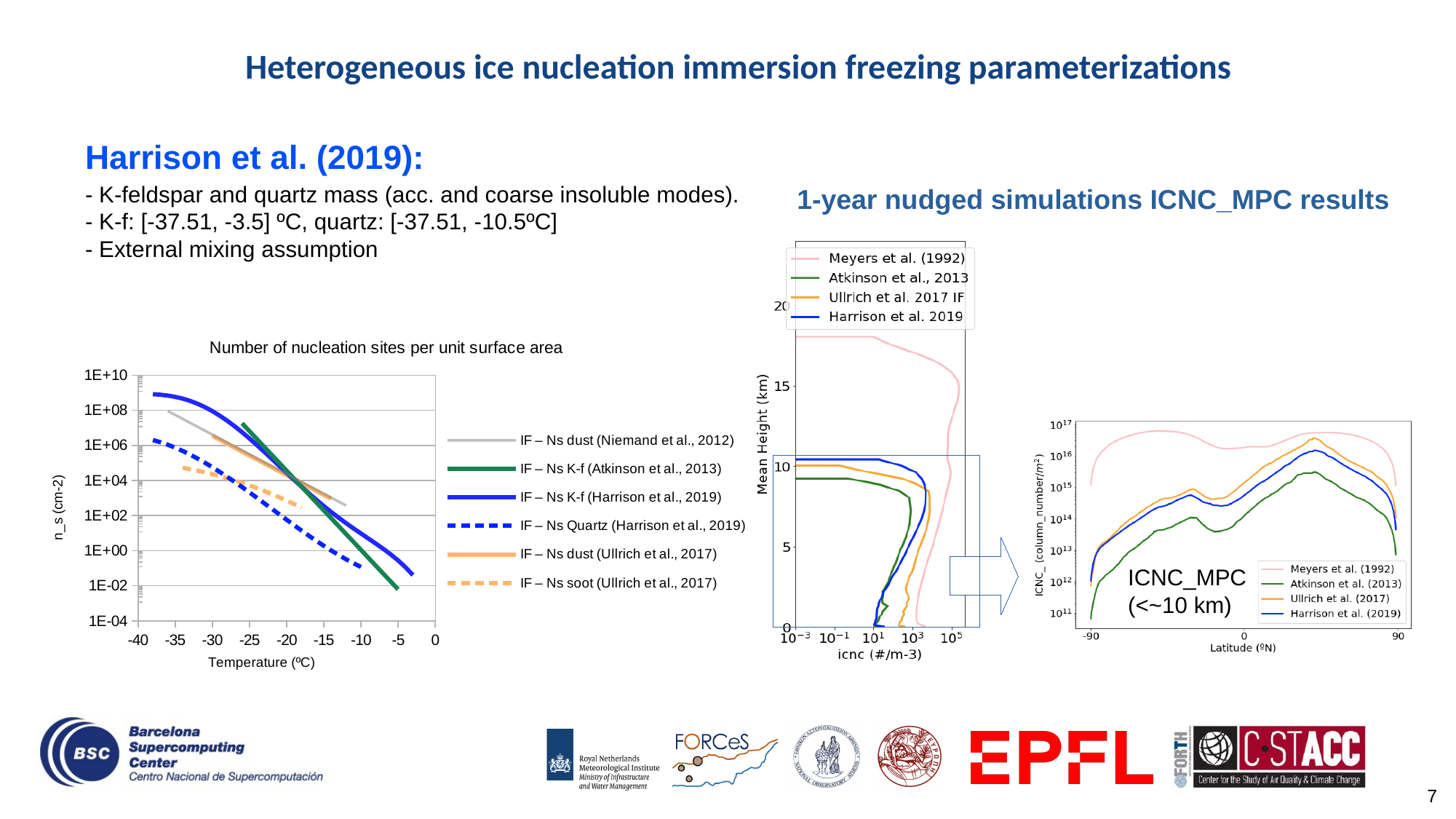
How many series does the legend of the 'Number of nucleation sites per unit surface area' chart list? 6 In the right-hand chart (ICNC column number versus Latitude), which series has the highest values across latitudes? Meyers et al. (1992) In the right-hand chart (ICNC column number versus Latitude), which series has the lowest values across latitudes? Atkinson et al. (2013) In the middle chart (icnc versus Mean Height), which series extends to the greatest mean height? Meyers et al. (1992) In the 'Number of nucleation sites per unit surface area' chart, is the value of IF – Ns K-f (Harrison et al., 2019) at -35 ºC greater or less than 1E+06? greater In the 'Number of nucleation sites per unit surface area' chart, is the value of IF – Ns K-f (Harrison et al., 2019) at -10 ºC greater or less than 1E+02? less What kind of chart is the 'Number of nucleation sites per unit surface area' chart on the left? line chart How many series does the legend of the middle chart (icnc versus Mean Height) list? 4 In the 'Number of nucleation sites per unit surface area' chart, do the plotted values rise or fall as temperature increases from -40 to 0 ºC? fall What is the x-axis label of the 'Number of nucleation sites per unit surface area' chart? Temperature (ºC) In the 'Number of nucleation sites per unit surface area' chart, which series is drawn as a blue dashed line? IF – Ns Quartz (Harrison et al., 2019) How many series does the legend of the right-hand chart (ICNC column number versus Latitude) list? 4